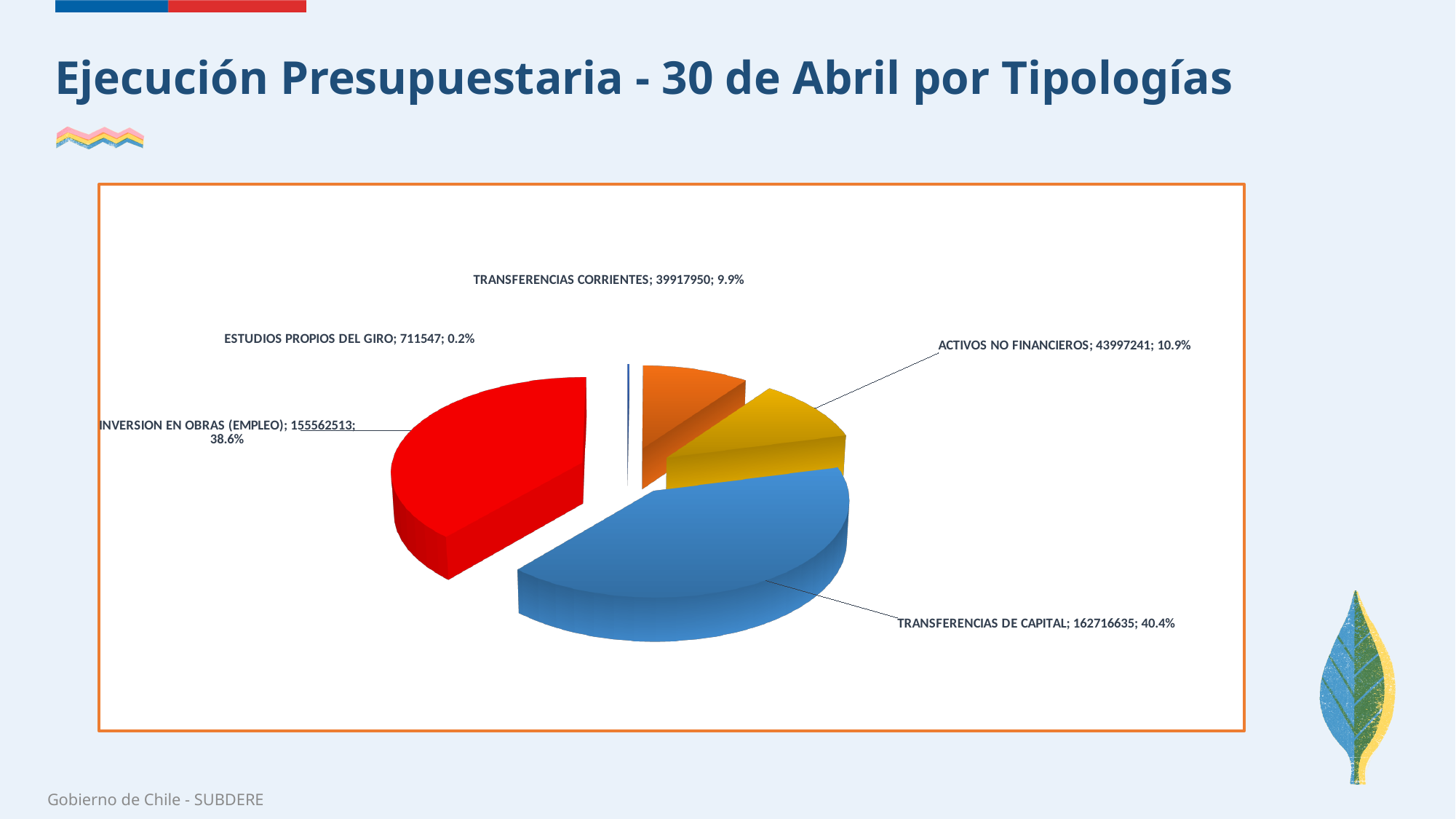
What is the difference between the values for TRANSFERENCIAS DE CAPITAL and INVERSION EN OBRAS (EMPLEO)? 7154122 What share of the pie does TRANSFERENCIAS CORRIENTES represent? 9.9% What is the value for ESTUDIOS PROPIOS DEL GIRO? 711547 Which category has the smallest slice of the pie? ESTUDIOS PROPIOS DEL GIRO What kind of chart is shown on the slide? Pie chart Which is larger, the value for ACTIVOS NO FINANCIEROS or the value for TRANSFERENCIAS CORRIENTES? ACTIVOS NO FINANCIEROS What colour is the slice for INVERSION EN OBRAS (EMPLEO)? Red How many slices does the pie chart have? 5 What share of the pie does ACTIVOS NO FINANCIEROS represent? 10.9% Which category has the largest slice of the pie? TRANSFERENCIAS DE CAPITAL What is the value for TRANSFERENCIAS DE CAPITAL? 162716635 What is the value for INVERSION EN OBRAS (EMPLEO)? 155562513